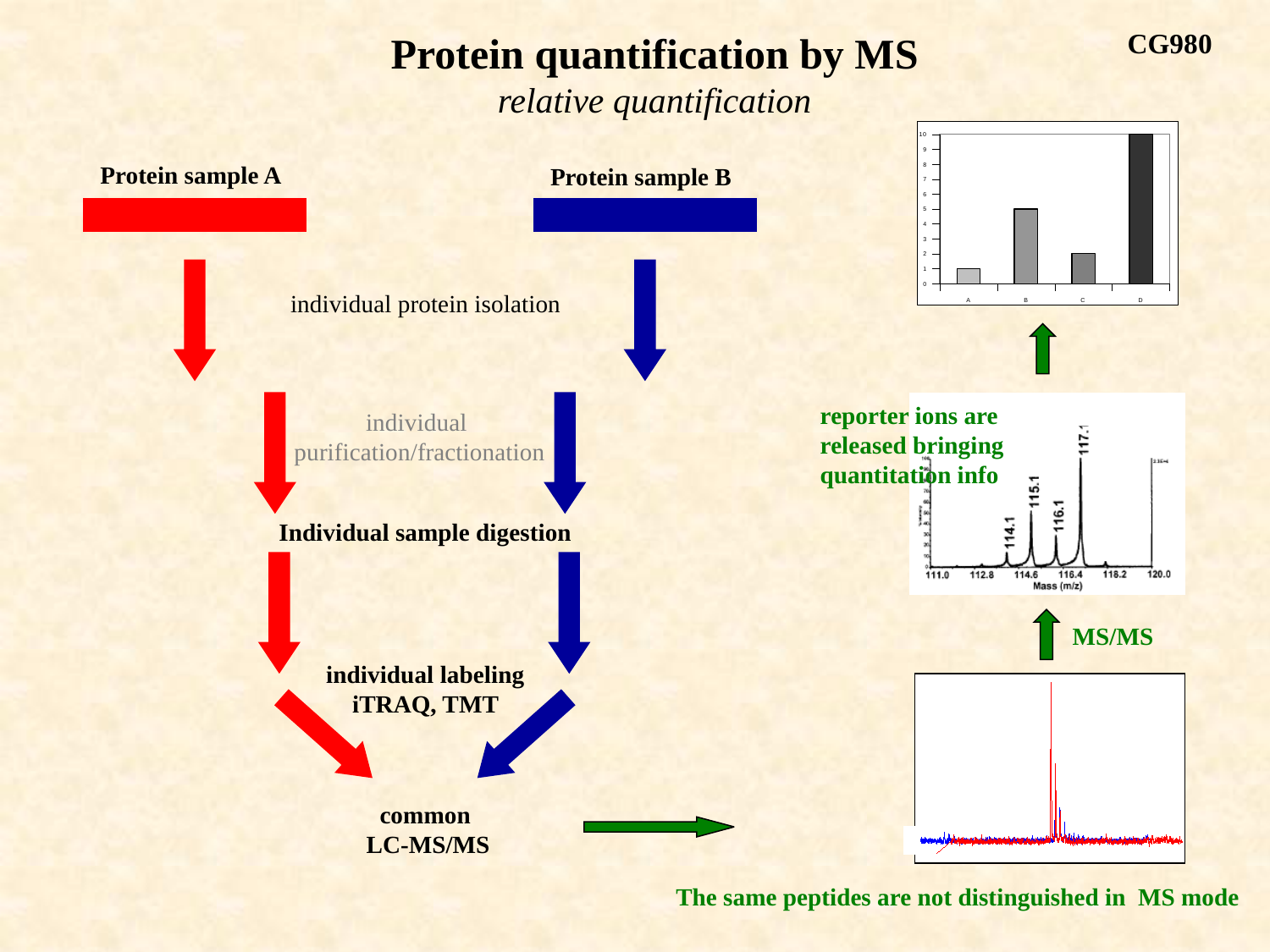
In the bar chart in the top right, how many categories are shown on the x axis? 4 In the bar chart in the top right, which category has the highest bar? D In the bar chart in the top right, what is the difference between the values for D and B? 5 In the mass spectrum in the middle right of the slide, what is the label on the x axis? Mass (m/z) In the bar chart in the top right, what is the value for category B? 5 In the bar chart in the top right, is the value for C greater or less than 5? less In the bar chart in the top right, which is larger, the value for B or the value for C? B In the bar chart in the top right, which category has the lowest bar? A In the bar chart in the top right, what is the value for category D? 10 In the bar chart in the top right, what is the value for category A? 1 What kind of chart is shown in the top right of the slide? bar chart In the bar chart in the top right, what is the value for category C? 2